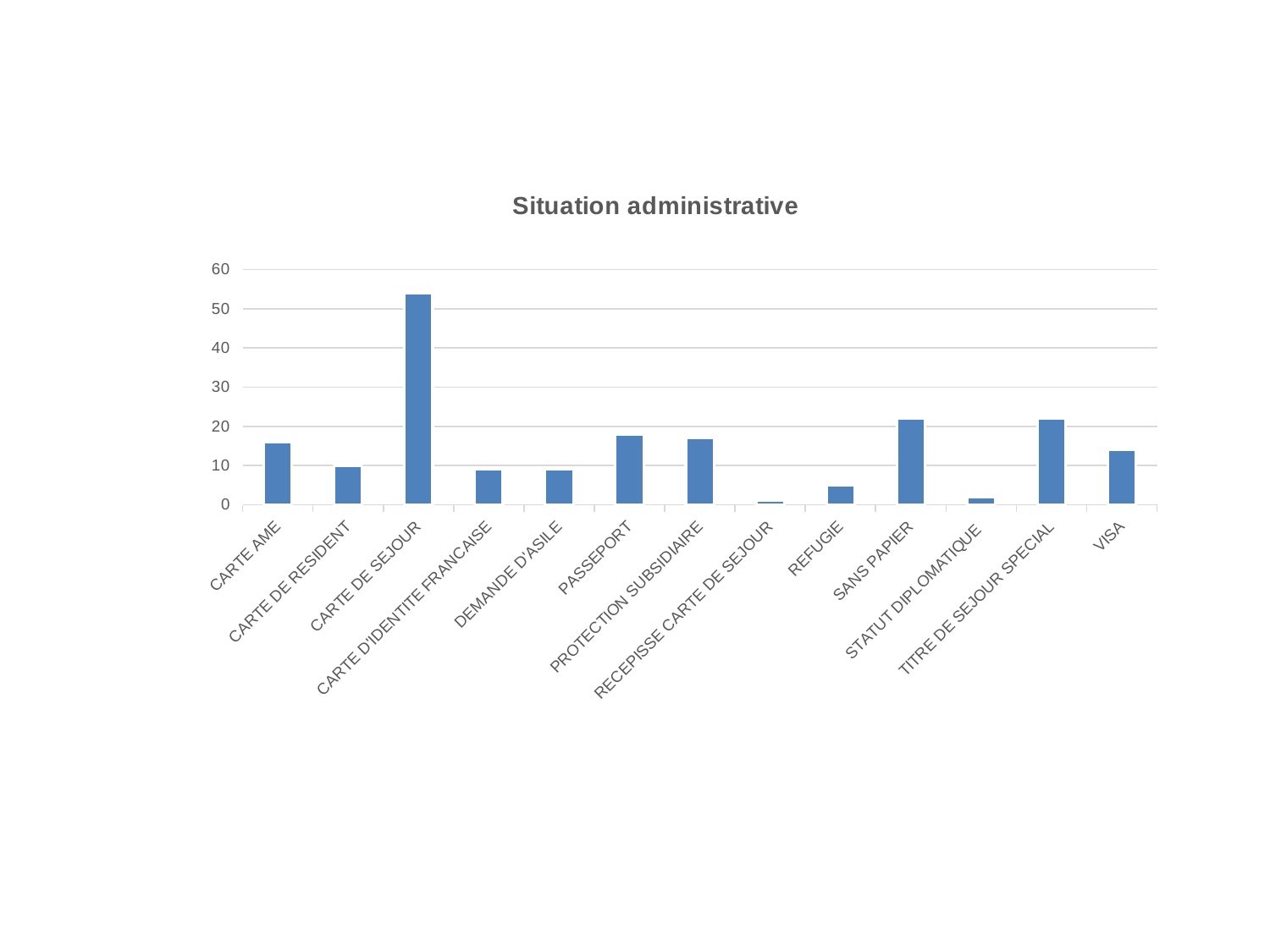
Is the value for SANS PAPIER greater or less than 20? greater Which category has the highest value? CARTE DE SEJOUR Is the value for CARTE DE SEJOUR greater or less than 50? greater What kind of chart is shown on the slide? bar chart Is the value for REFUGIE greater or less than 10? less Which is larger, the value for PASSEPORT or the value for VISA? PASSEPORT How many categories are shown on the x axis of the chart? 13 Which is larger, the value for CARTE AME or the value for CARTE DE RESIDENT? CARTE AME What is the title of the chart? Situation administrative Which category has the lowest value? RECEPISSE CARTE DE SEJOUR